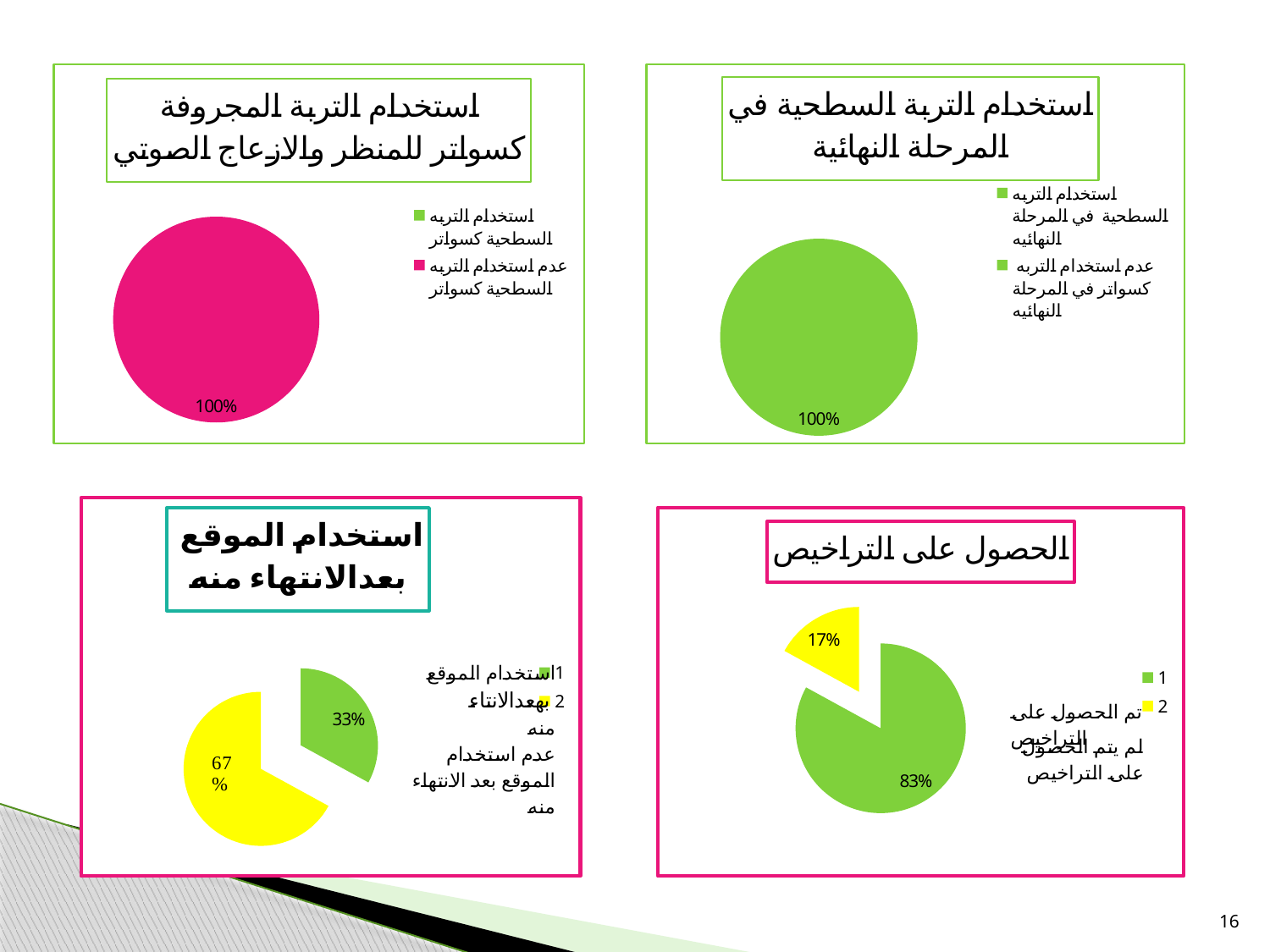
In the bottom-right chart titled "الحصول على التراخيص", what is the difference between the two slices' percentages? 66% In the bottom-right chart titled "الحصول على التراخيص", what percentage is shown for the green slice? 83% In the top-right chart titled "استخدام التربة السطحية في المرحلة النهائية", what percentage is printed on the pie? 100% In the bottom-right chart titled "الحصول على التراخيص", what percentage is shown for the yellow slice? 17% How many charts are shown on the slide? 4 What type of chart is the bottom-right chart titled "الحصول على التراخيص"? pie chart How many entries does the legend of the bottom-right chart titled "الحصول على التراخيص" list? 2 In the top-left chart titled "استخدام التربة المجروفة كسواتر للمنظر والازعاج الصوتي", what percentage is printed on the pie? 100% In the bottom-left chart titled "استخدام الموقع بعدالانتهاء منه", what is the difference between the yellow and green slice percentages? 34% In the bottom-left chart titled "استخدام الموقع بعدالانتهاء منه", what percentage is shown for the green slice? 33% In the bottom-left chart titled "استخدام الموقع بعدالانتهاء منه", which slice is larger, the green one or the yellow one? the yellow one In the bottom-left chart titled "استخدام الموقع بعدالانتهاء منه", what percentage is shown for the yellow slice? 67%